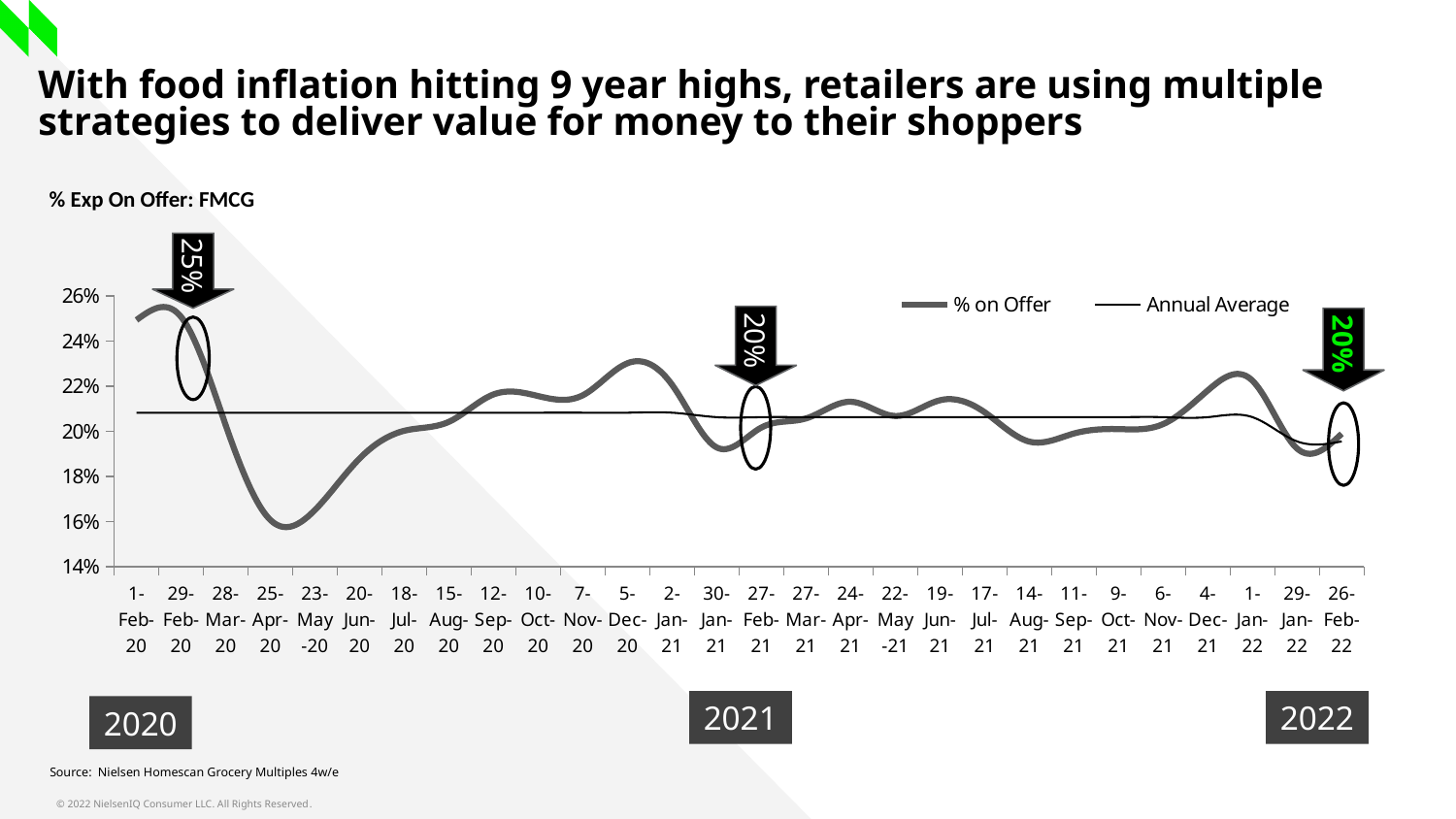
At which date does the % on Offer line reach its lowest point? 25-Apr-20 Is the % on Offer value for 5-Dec-20 greater or less than 22%? greater Does the % on Offer line rise or fall between 29-Feb-20 and 25-Apr-20? fall What are the two series named in the chart legend? % on Offer and Annual Average How many series does the chart legend list? 2 What is the title of the chart? % Exp On Offer: FMCG Is the % on Offer value for 1-Feb-20 greater or less than 24%? greater How many dates are labelled along the x axis of the chart? 28 At which date does the % on Offer line reach its highest point? 29-Feb-20 Is the % on Offer value for 25-Apr-20 greater or less than 18%? less Which has the higher % on Offer value, 5-Dec-20 or 25-Apr-20? 5-Dec-20 What kind of chart is shown on the slide? line chart